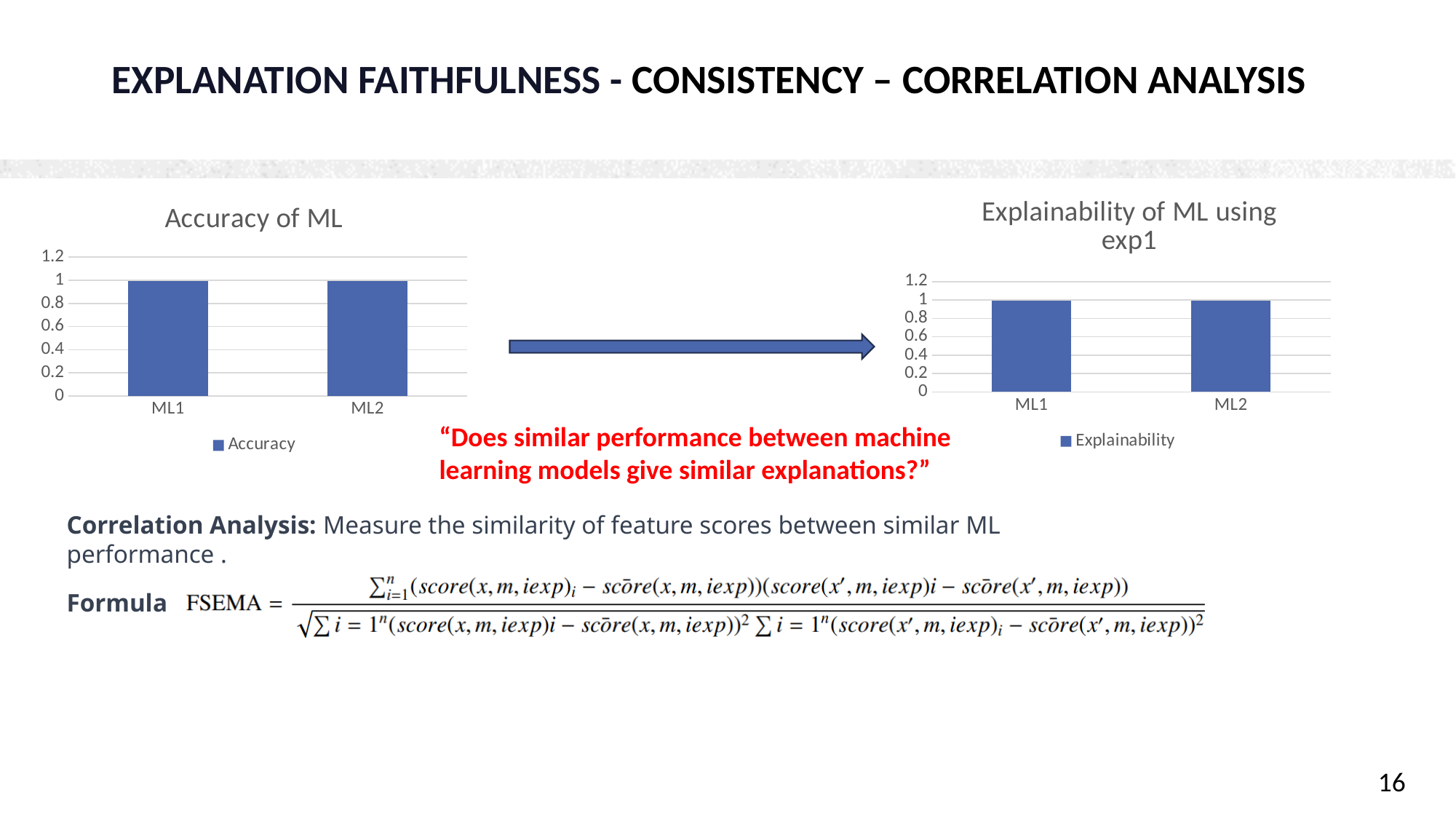
What is the legend entry of the 'Accuracy of ML' chart? Accuracy In the 'Explainability of ML using exp1' chart, is the value for ML2 greater or less than 0.6? greater What is the title of the chart on the right side of the slide? Explainability of ML using exp1 In the 'Accuracy of ML' chart, is the value for ML1 greater or less than 0.8? greater What kind of chart is the 'Accuracy of ML' chart? bar chart How many series does the legend of the 'Explainability of ML using exp1' chart list? 1 In the 'Accuracy of ML' chart, what is the difference between the values for ML1 and ML2? 0 How many categories are shown in the 'Accuracy of ML' chart? 2